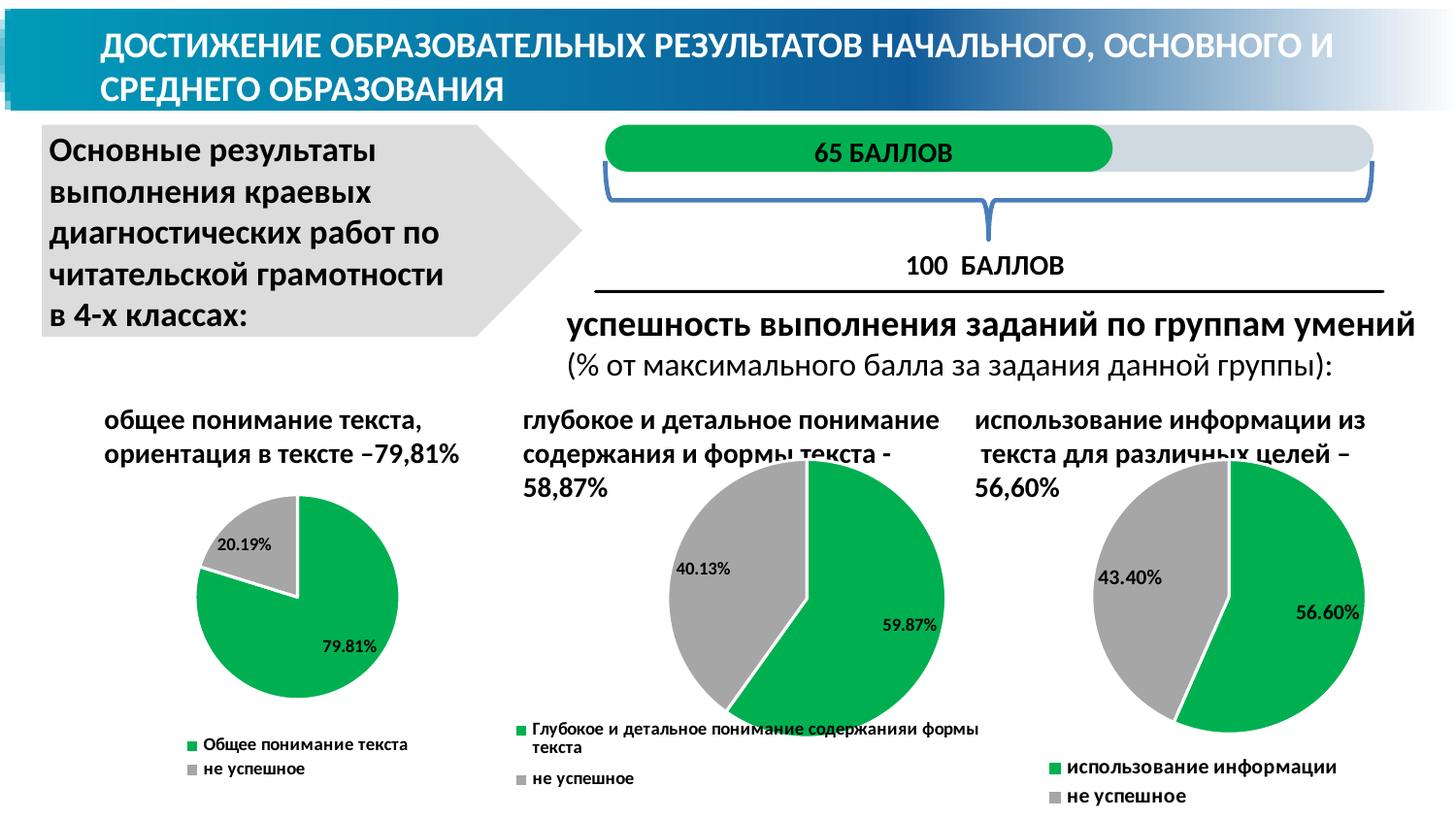
In the middle pie chart (глубокое и детальное понимание), what percentage is shown for the green slice? 59.87% In the left pie chart (общее понимание текста), what percentage is shown for the grey slice 'не успешное'? 20.19% In the middle pie chart (глубокое и детальное понимание), what is the difference in percentage points between the green slice and the 'не успешное' slice? 19.74 What type of chart is the middle chart (глубокое и детальное понимание)? Pie chart In the right pie chart (использование информации), which slice is the smallest? не успешное In the right pie chart (использование информации), what percentage is shown for the 'использование информации' slice? 56.60% In the middle pie chart (глубокое и детальное понимание), what percentage is shown for the 'не успешное' slice? 40.13% How many slices does the left pie chart (общее понимание текста) have? 2 In the right pie chart (использование информации), which slice is larger: 'использование информации' or 'не успешное'? использование информации In the left pie chart (общее понимание текста), what percentage is shown for the green slice 'Общее понимание текста'? 79.81% In the left pie chart (общее понимание текста), which slice is the largest? Общее понимание текста In the right pie chart (использование информации), what percentage is shown for the 'не успешное' slice? 43.40%